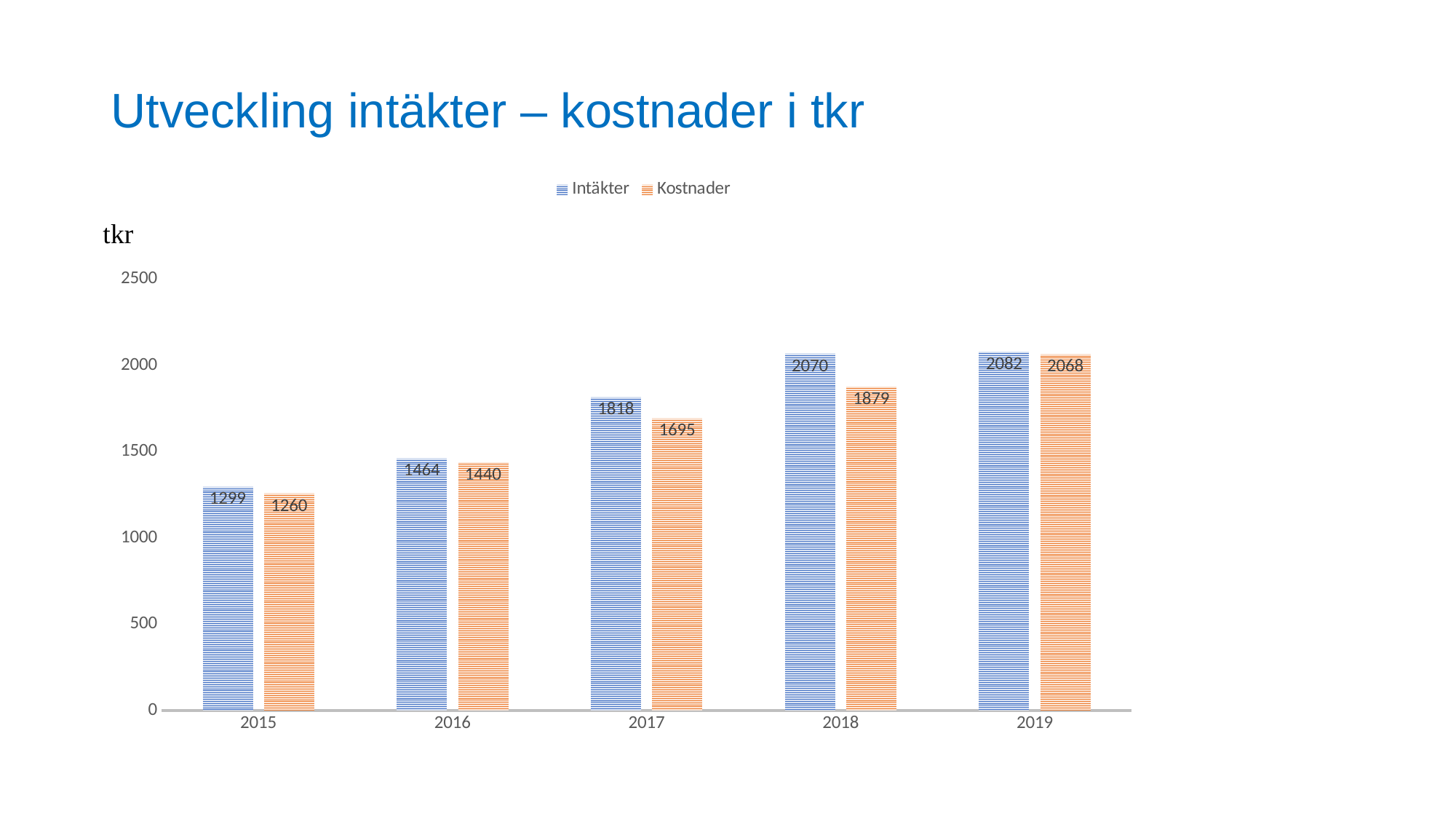
How many years are shown on the x axis? 5 What is the value of Kostnader for 2015? 1260 What kind of chart is shown on the slide? Bar chart How many series does the legend list? 2 What is the difference between Intäkter in 2016 and Intäkter in 2015? 165 Which year has the highest Intäkter value? 2019 Which year has the lowest Kostnader value? 2015 Do the Kostnader values rise or fall from 2015 to 2019? Rise Which is larger in 2017, Intäkter or Kostnader? Intäkter What is the difference between Intäkter and Kostnader in 2018? 191 What is the value of Kostnader for 2018? 1879 What is the value of Intäkter for 2017? 1818